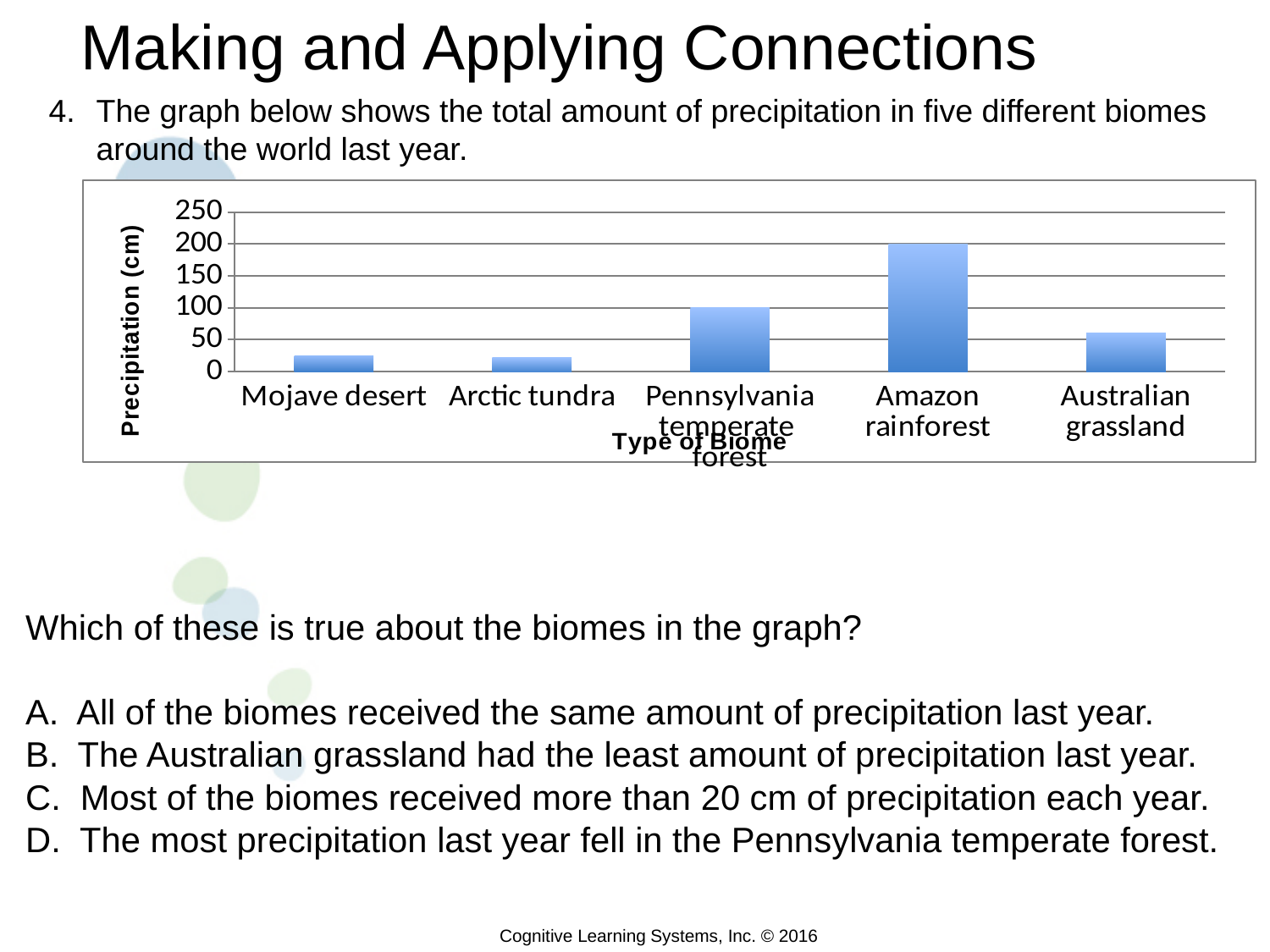
Which has more precipitation, the Australian grassland or the Mojave desert? Australian grassland Is the precipitation value for the Australian grassland greater or less than 50? greater What is the label on the vertical axis of the chart? Precipitation (cm) Is the precipitation value for the Arctic tundra greater or less than 50? less Which has more precipitation, the Pennsylvania temperate forest or the Australian grassland? Pennsylvania temperate forest Which biome has the highest precipitation in the chart? Amazon rainforest Is the precipitation value for the Mojave desert greater or less than 50? less What is the precipitation value for the Amazon rainforest? 200 What is the precipitation value for the Pennsylvania temperate forest? 100 What kind of chart is shown on the slide? bar chart What is the difference in precipitation between the Amazon rainforest and the Pennsylvania temperate forest? 100 How many biomes are shown on the x axis of the chart? 5